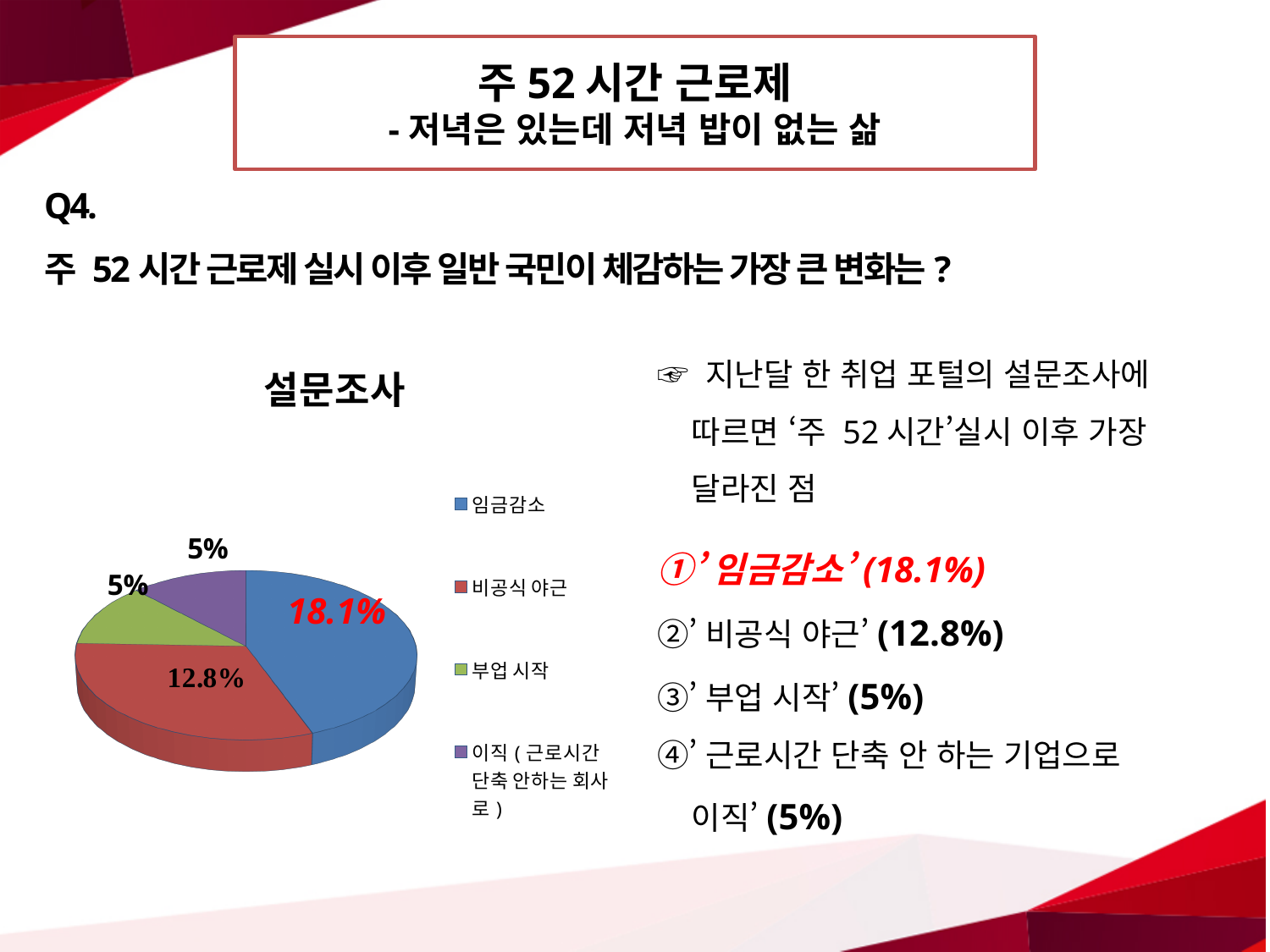
How many entries does the legend list? 4 Is the value for 임금감소 greater or less than 15%? greater What value is shown for 임금감소 in the pie chart? 18.1% What is the difference between the values for 임금감소 and 비공식 야근? 5.3% How many categories does the pie chart have? 4 What value is shown for 비공식 야근 in the pie chart? 12.8% What kind of chart is shown on the slide? pie chart What is the title of the chart? 설문조사 What colour is the 임금감소 slice in the pie chart? blue Which category has the largest slice in the pie chart? 임금감소 Which is larger, the value for 비공식 야근 or the value for 부업 시작? 비공식 야근 What value is shown for 부업 시작 in the pie chart? 5%